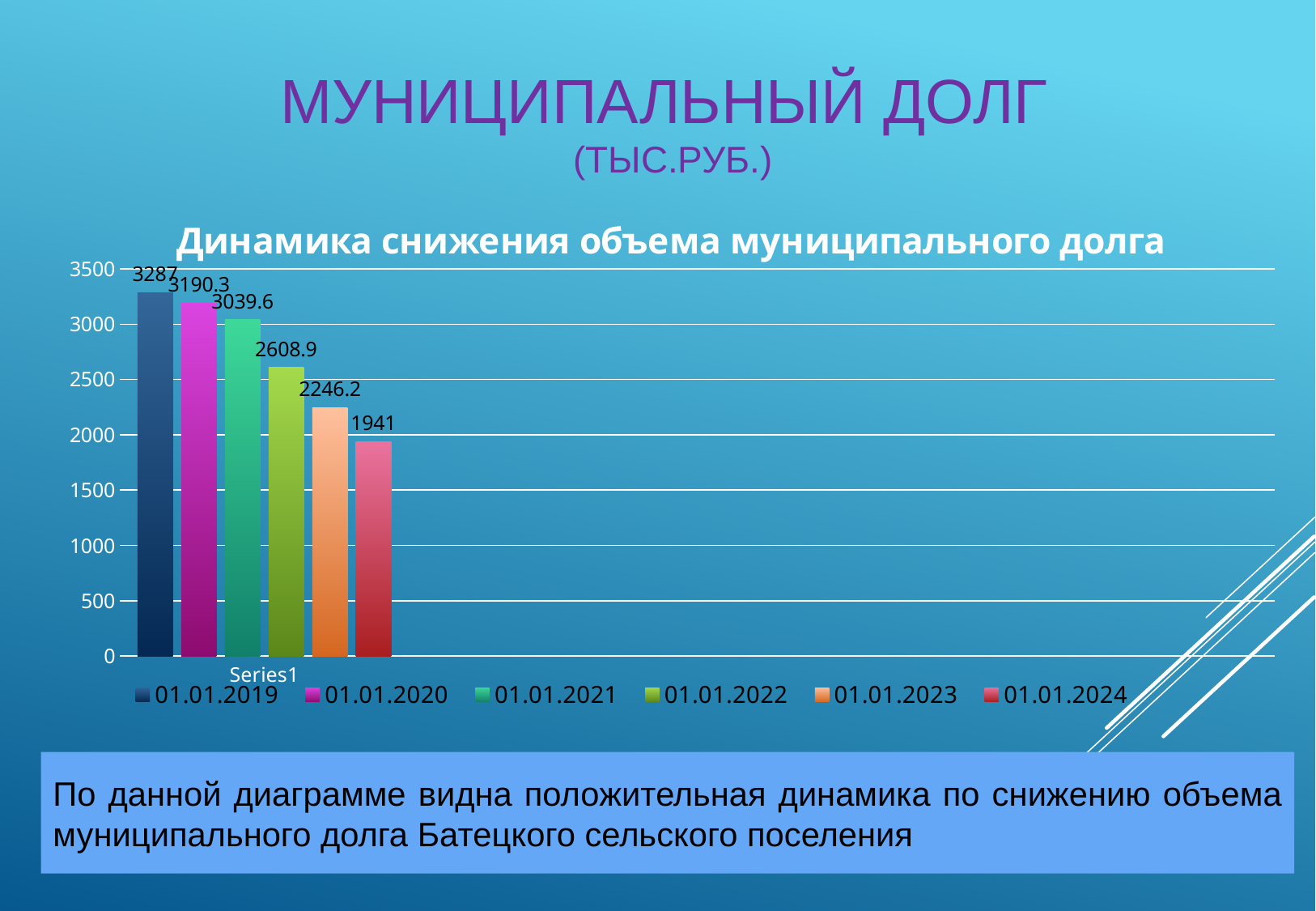
What type of chart is shown on the slide? bar chart What is the title of the chart? Динамика снижения объема муниципального долга What is the value for 01.01.2024? 1941 Which date has the lowest value? 01.01.2024 What is the value for 01.01.2022? 2608.9 How many entries does the legend list? 6 What is the difference between the values for 01.01.2019 and 01.01.2024? 1346 Which is larger, the value for 01.01.2020 or the value for 01.01.2023? 01.01.2020 Which date has the highest value? 01.01.2019 What is the difference between the values for 01.01.2021 and 01.01.2022? 430.7 What is the value for 01.01.2019? 3287 Do the values rise or fall from 01.01.2019 to 01.01.2024? fall